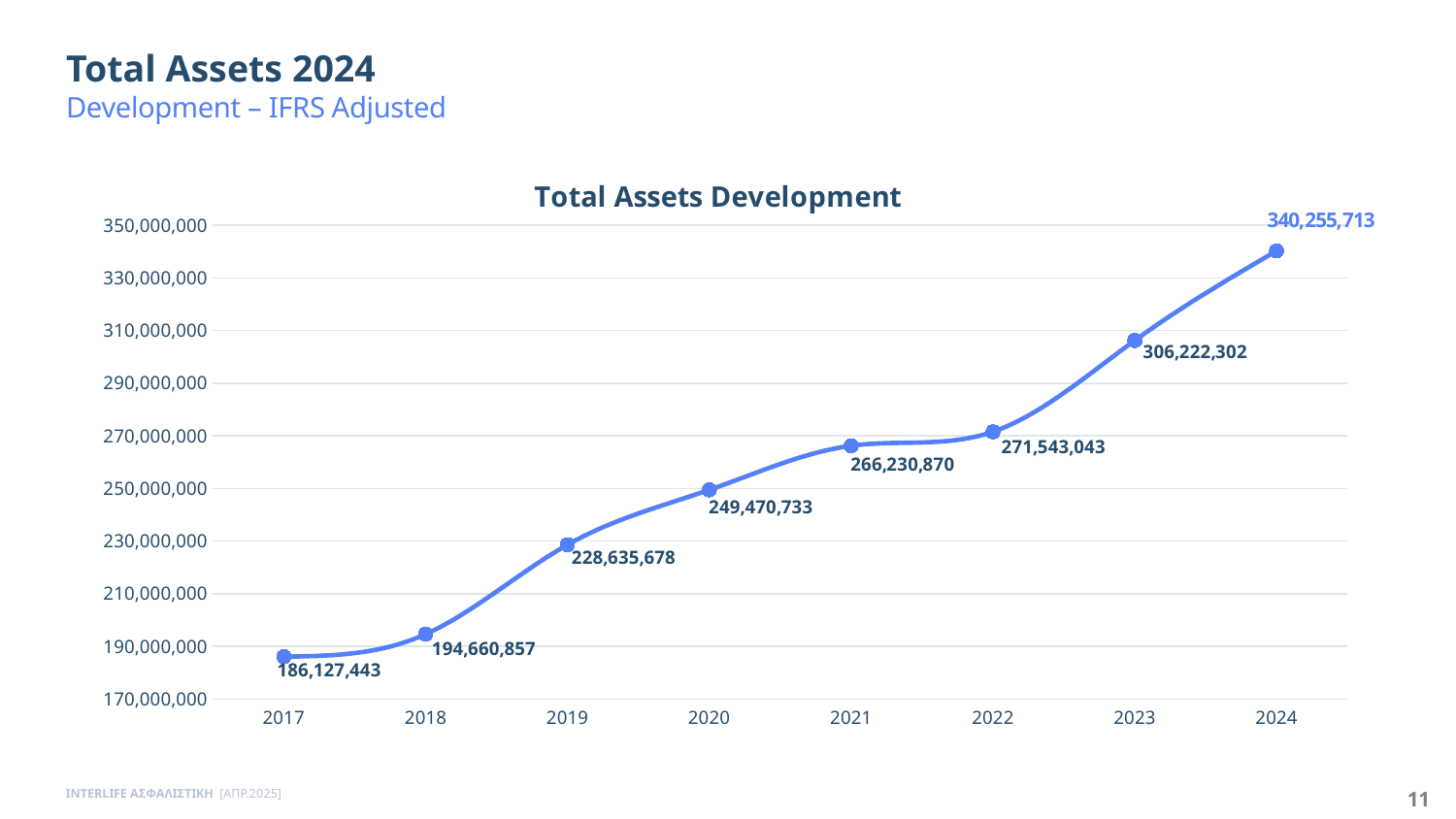
What is the value for 2024 in the Total Assets Development chart? 340,255,713 Which is larger in the Total Assets Development chart, the value for 2019 or the value for 2021? 2021 Which year has the highest value in the Total Assets Development chart? 2024 What is the value for 2020 in the Total Assets Development chart? 249,470,733 What is the value for 2022 in the Total Assets Development chart? 271,543,043 What is the value for 2017 in the Total Assets Development chart? 186,127,443 Which year has the lowest value in the Total Assets Development chart? 2017 What is the difference between the 2018 and 2017 values in the Total Assets Development chart? 8,533,414 Do the values in the Total Assets Development chart rise or fall from 2017 to 2024? Rise What is the difference between the 2024 and 2023 values in the Total Assets Development chart? 34,033,411 What kind of chart is the Total Assets Development chart? Line chart How many years are plotted in the Total Assets Development chart? 8